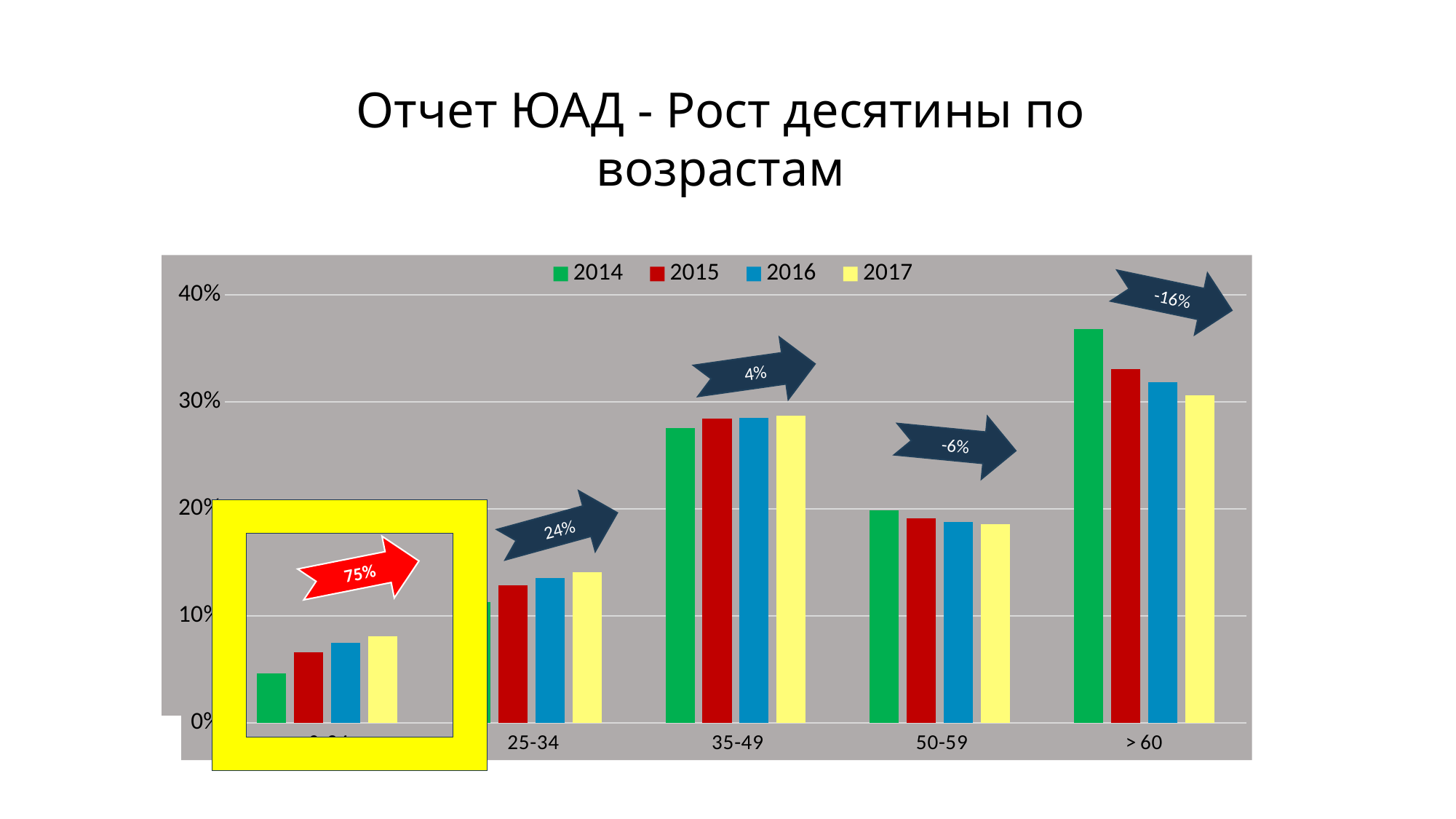
For the 25-34 age group, which is larger: the 2015 value or the 2017 value? 2017 For the > 60 age group, do the bars rise or fall from 2014 to 2017? fall For the > 60 age group, which is larger: the 2014 value or the 2017 value? 2014 How many series does the legend list? 4 What percentage is written on the arrow above the 35-49 age group? 4% Is the 2017 value for the 50-59 age group greater or less than 20%? less What kind of chart is shown on the slide? bar chart Is the 2014 value for the > 60 age group greater or less than 30%? greater Is the 2017 value for the 35-49 age group greater or less than 30%? less Which age group has the highest bars overall? > 60 How many age-group categories are plotted along the x axis? 5